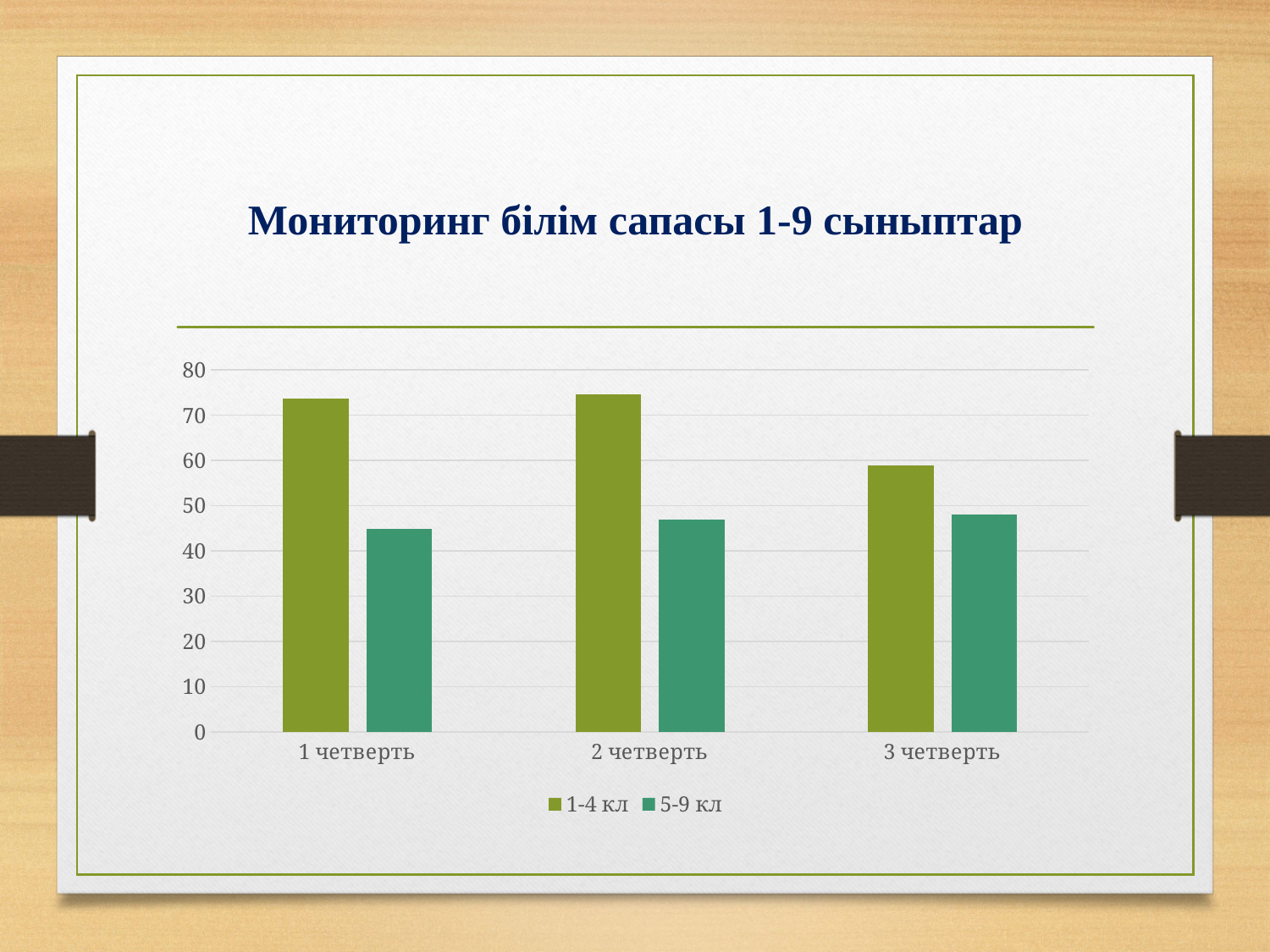
Is the value for 1-4 кл in 1 четверть greater or less than 70? greater How many series does the legend list? 2 For the 1-4 кл series, which category has the lowest value? 3 четверть Is the value for 5-9 кл in 3 четверть greater or less than 40? greater Is the value for 5-9 кл in 1 четверть greater or less than 50? less In 2 четверть, which series has the larger value, 1-4 кл or 5-9 кл? 1-4 кл Which series does the legend list first? 1-4 кл What kind of chart is shown on the slide? bar chart How many categories are shown on the x axis? 3 What is the title of the chart? Мониторинг білім сапасы 1-9 сыныптар